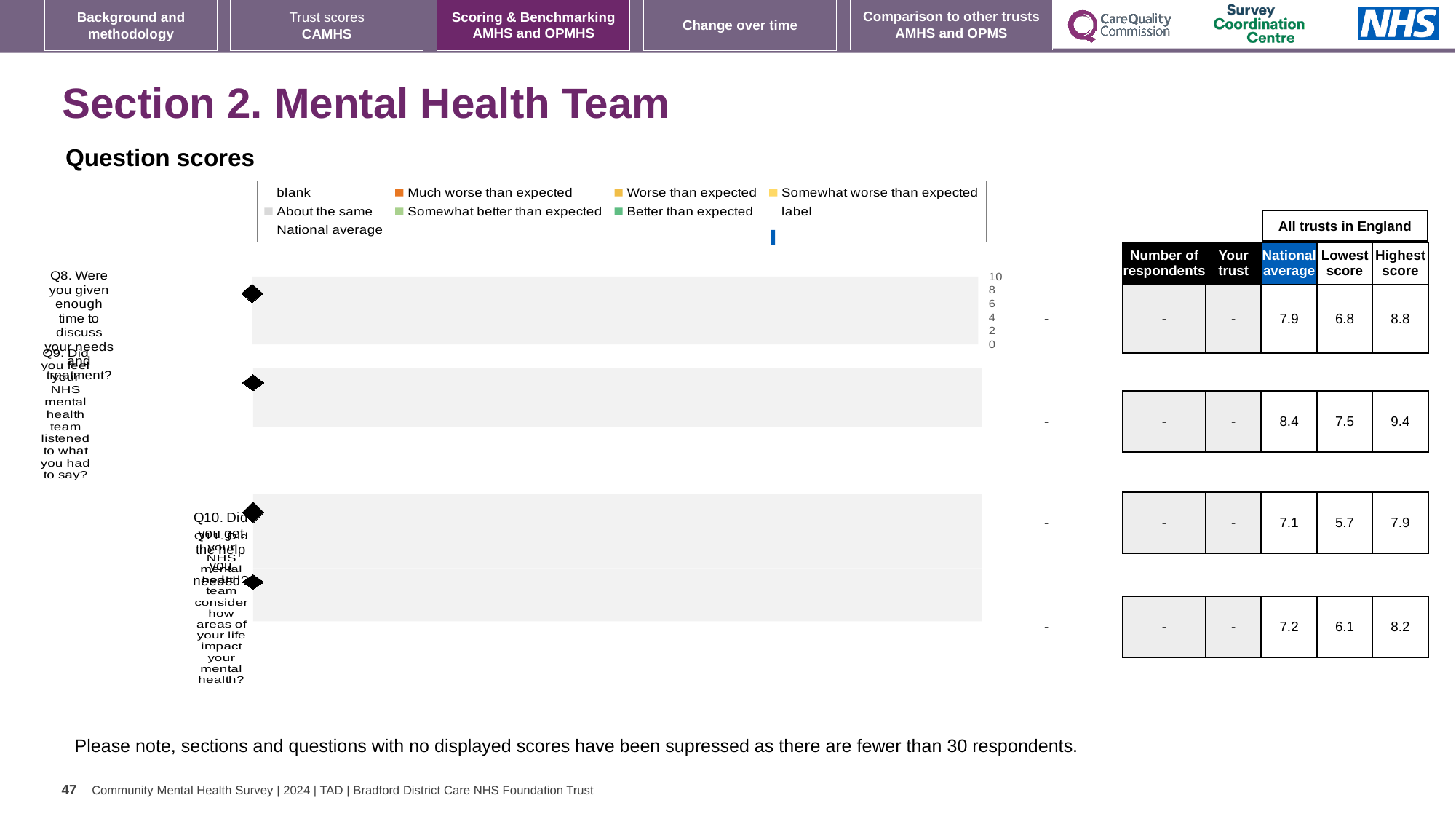
How many question rows (categories) are plotted in the 'Question scores' chart? 4 In the table beside the chart, what is the difference between the Highest score and the Lowest score for Q8? 2.0 How many entries does the legend of the 'Question scores' chart list? 9 What kind of chart is shown under the heading 'Question scores'? bar chart Among Q8, Q9 and Q10, which question has the highest National average in the table beside the chart? Q9 What is the first legend entry listed for the 'Question scores' chart? blank What is the highest tick value shown on the score axis of the 'Question scores' chart? 10 Among Q8, Q9 and Q10, which question has the lowest National average in the table beside the chart? Q10 In the table beside the chart, what is the National average for Q8 (Were you given enough time to discuss your needs and treatment?)? 7.9 In the table beside the chart, what is the Highest score for Q9 (Did you feel your NHS mental health team listened to what you had to say?)? 9.4 In the table beside the chart, what value is shown for 'Your trust' for Q8? - In the table beside the chart, what is the Lowest score for Q10 (Did you get the help you needed?)? 5.7